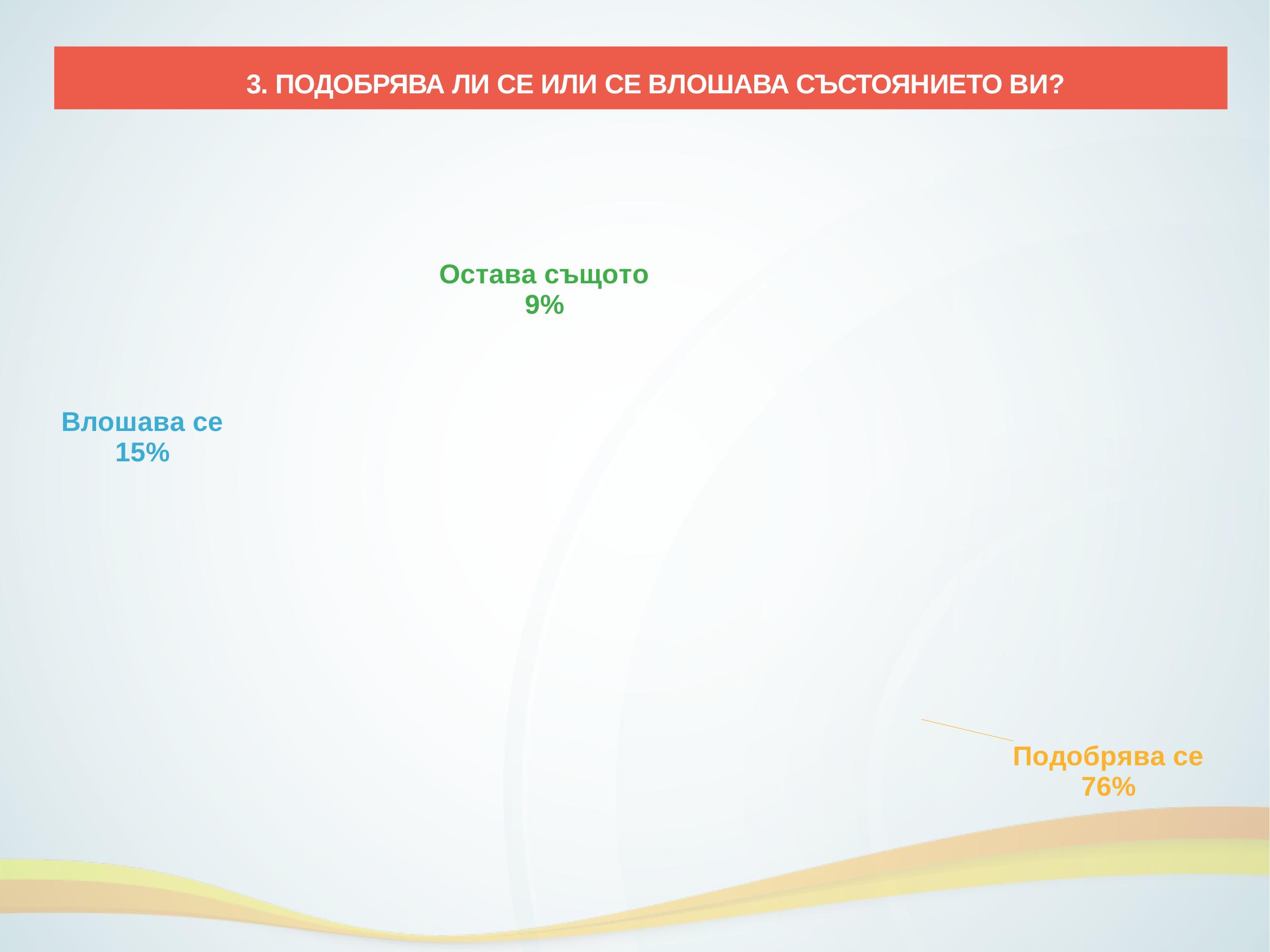
What is the total of the three percentages shown? 100% What percentage is shown for "Подобрява се"? 76% Which category has the lowest percentage? Остава същото What is the difference in percentage points between "Влошава се" and "Остава същото"? 6 In what colour is the label "Подобрява се 76%" written? Orange What is the title of the slide containing the chart? 3. ПОДОБРЯВА ЛИ СЕ ИЛИ СЕ ВЛОШАВА СЪСТОЯНИЕТО ВИ? What is the difference in percentage points between "Подобрява се" and "Влошава се"? 61 Which is larger, the percentage for "Влошава се" or for "Остава същото"? Влошава се How many categories are labelled on the chart? 3 What percentage is shown for "Остава същото"? 9% Which category has the highest percentage? Подобрява се What percentage is shown for "Влошава се"? 15%